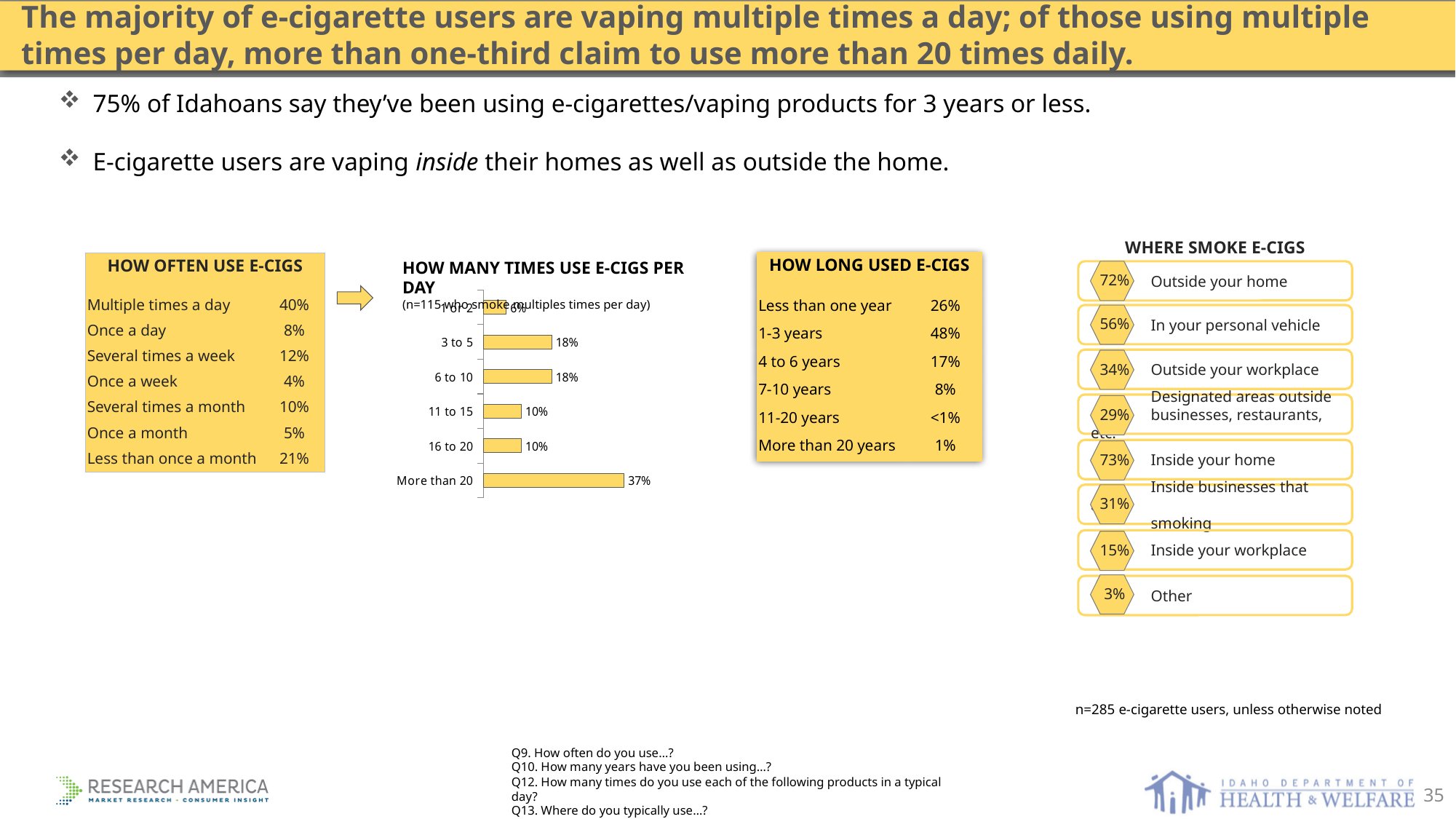
According to the subtitle of the 'HOW MANY TIMES USE E-CIGS PER DAY' chart, what is the sample size (n)? 115 In the 'HOW MANY TIMES USE E-CIGS PER DAY' chart, what is the difference between 'More than 20' and '16 to 20'? 27% What type of chart is 'HOW MANY TIMES USE E-CIGS PER DAY'? Bar chart In the 'HOW MANY TIMES USE E-CIGS PER DAY' chart, which category has the highest value? More than 20 In the 'HOW MANY TIMES USE E-CIGS PER DAY' chart, what is the value for '3 to 5' times? 18% In the 'HOW MANY TIMES USE E-CIGS PER DAY' chart, what percentage of users use e-cigs more than 20 times per day? 37% In the 'HOW MANY TIMES USE E-CIGS PER DAY' chart, which is larger: '6 to 10' or '16 to 20'? 6 to 10 In the 'HOW MANY TIMES USE E-CIGS PER DAY' chart, what is the value for '6 to 10' times? 18% How many categories are shown in the 'HOW MANY TIMES USE E-CIGS PER DAY' chart? 6 What colour are the bars in the 'HOW MANY TIMES USE E-CIGS PER DAY' chart? Yellow In the 'HOW MANY TIMES USE E-CIGS PER DAY' chart, what is the difference between '3 to 5' and '11 to 15'? 8% In the 'HOW MANY TIMES USE E-CIGS PER DAY' chart, what is the value for '11 to 15' times? 10%